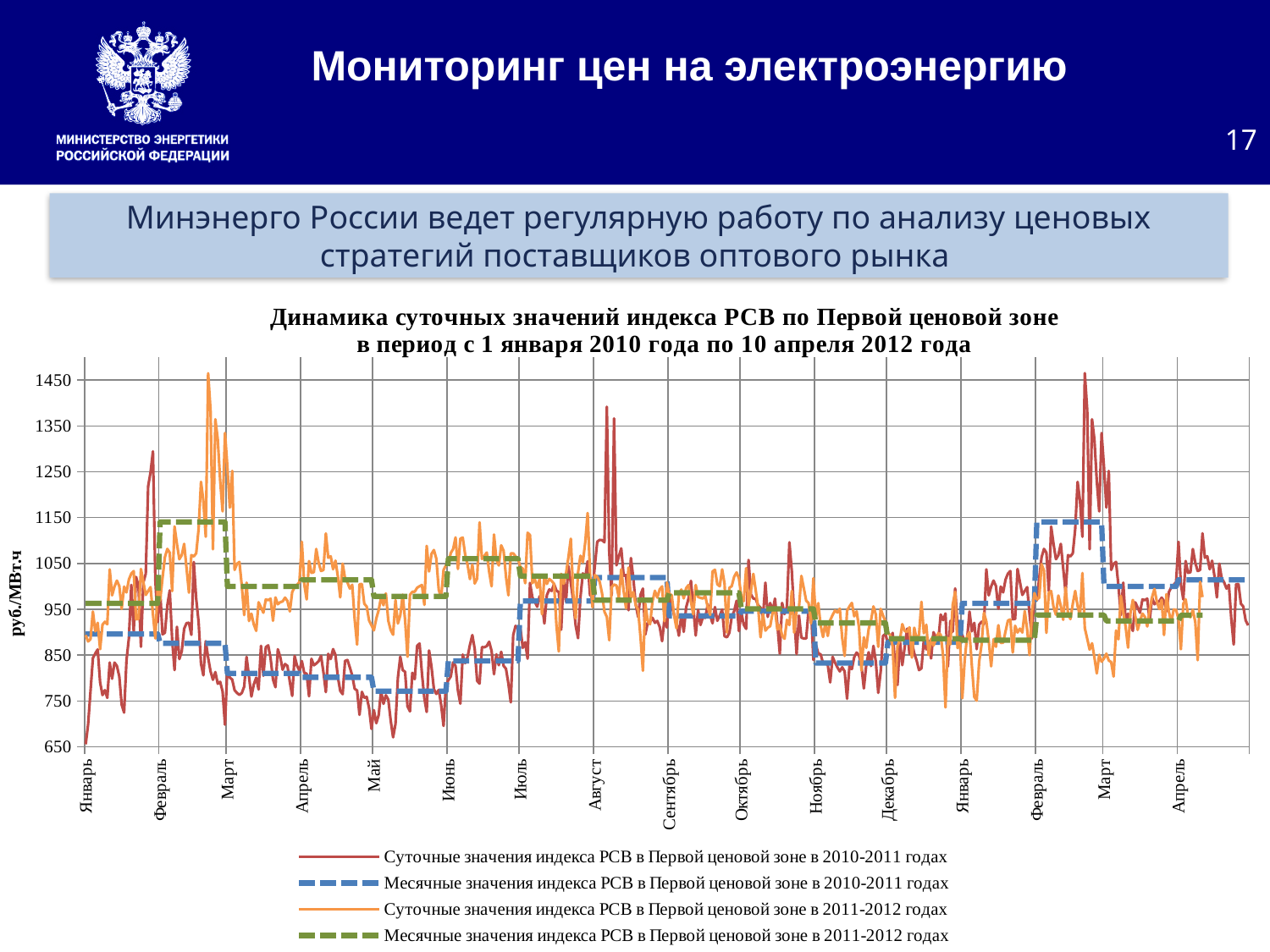
What is the title of the chart? Динамика суточных значений индекса РСВ по Первой ценовой зоне в период с 1 января 2010 года по 10 апреля 2012 года Is the monthly value of the РСВ index for 2010-2011 (blue dashed line) in the first Июнь greater or less than 850? less Is the monthly value of the РСВ index for 2010-2011 (blue dashed line) in the second Февраль greater or less than 1050? greater Is the monthly value of the РСВ index for 2011-2012 (green dashed line) in the first Февраль greater or less than 1050? greater In the second Март, which monthly series is higher: the 2010-2011 monthly line or the 2011-2012 monthly line? 2010-2011 monthly line Does the monthly 2010-2011 line (blue dashed) rise or fall from the first Январь to the first Май? fall What unit is shown on the vertical axis label of the chart? руб./МВт.ч In the first Февраль, which monthly series is higher: the 2010-2011 monthly line or the 2011-2012 monthly line? 2011-2012 monthly line How many month labels are shown along the x axis of the chart? 16 What kind of chart is shown on the slide? Line chart How many series does the chart legend list? 4